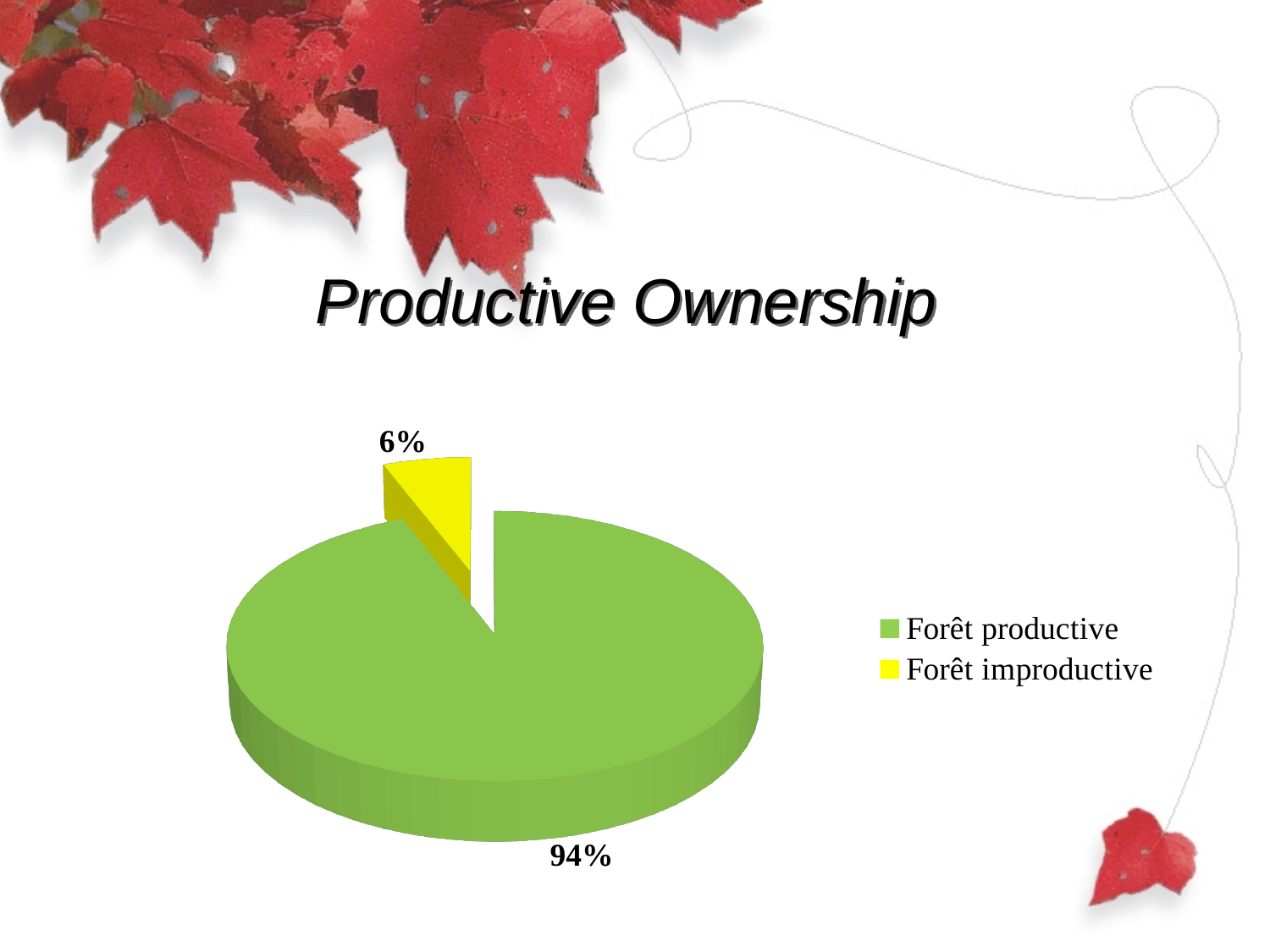
What share of the pie does Forêt improductive represent? 6% What is the title of the slide containing the chart? Productive Ownership How many entries does the legend list? 2 Which is larger, the slice for Forêt productive or the slice for Forêt improductive? Forêt productive What is the difference in percentage points between Forêt productive and Forêt improductive? 88 What kind of chart is shown on the slide? Pie chart What colour is the slice for Forêt improductive? Yellow What share of the pie does Forêt productive represent? 94% Which category has the largest slice of the pie? Forêt productive Which category has the smallest slice of the pie? Forêt improductive How many slices does the pie chart have? 2